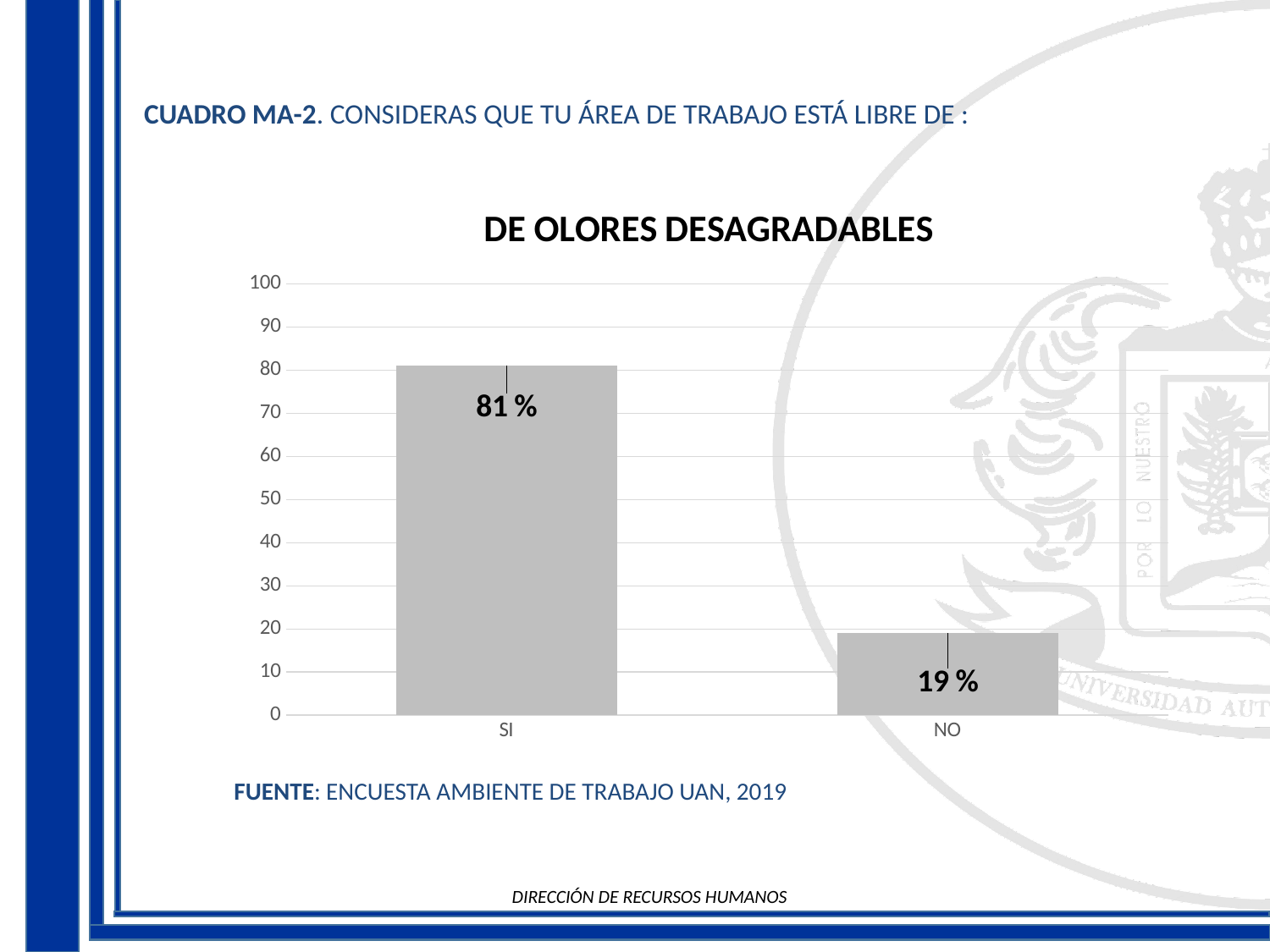
Is the value for NO greater or less than 20? less What is the value for SI? 81 % Which category has the highest value? SI What is the difference between the values for SI and NO? 62 % Is the value for SI greater or less than 80? greater What kind of chart is shown on the slide? bar chart What is the value for NO? 19 % What is the maximum value shown on the y axis? 100 How many categories are shown on the x axis? 2 What is the title of the chart? DE OLORES DESAGRADABLES Which is larger, the value for SI or the value for NO? SI Which category has the lowest value? NO